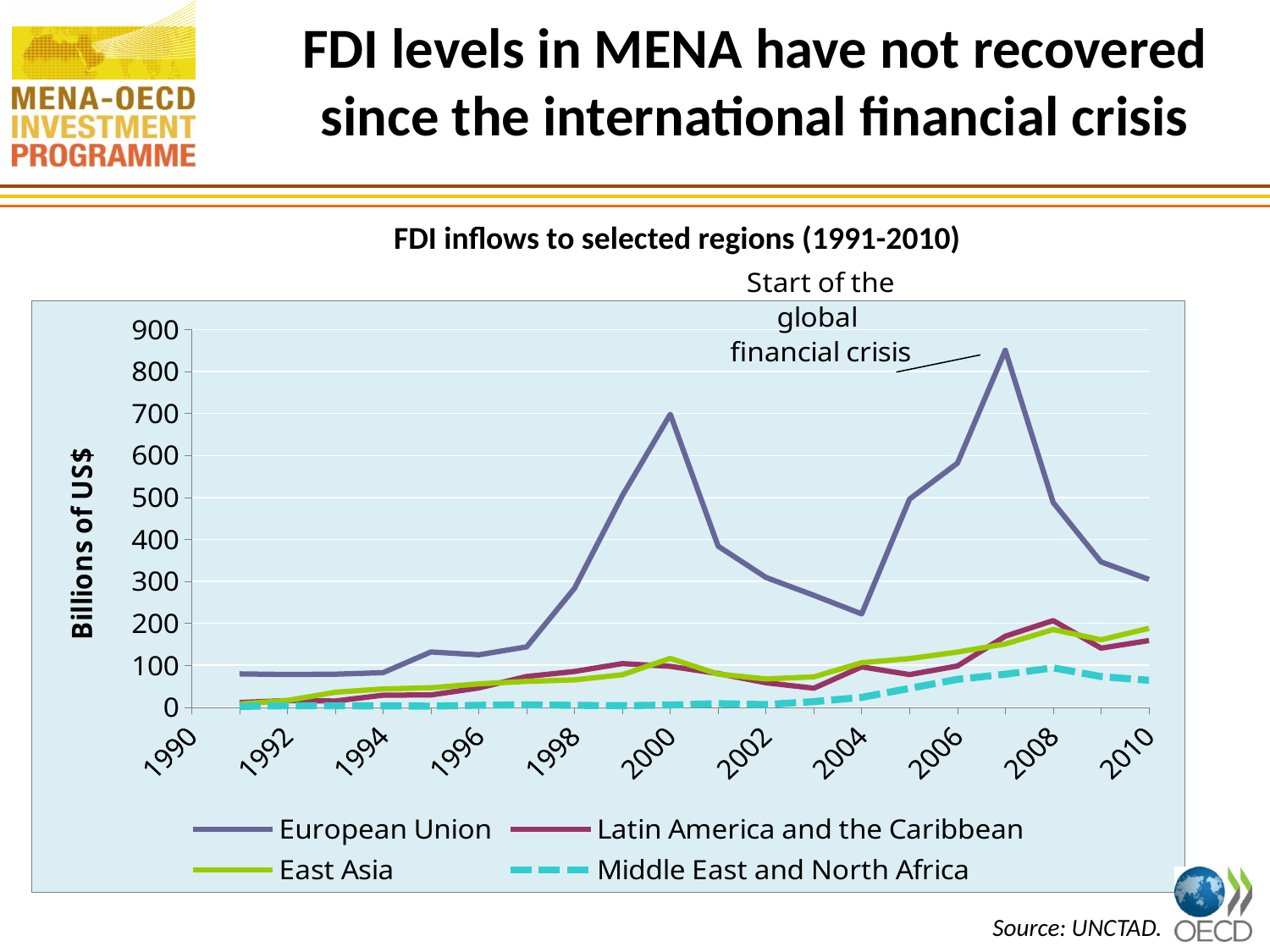
Is the value for European Union in 2010 greater or less than 400? less Which series has the highest value in 2007? European Union Do the values for European Union rise or fall from 2007 to 2010? fall In 2010, which is larger: East Asia or Latin America and the Caribbean? East Asia What is the title of the chart? FDI inflows to selected regions (1991-2010) Is the value for European Union in 2000 greater or less than 600? greater How many series does the legend list? 4 What kind of chart is shown on the slide? line chart What is the label on the vertical axis? Billions of US$ Which series has the lowest value in 2010? Middle East and North Africa Is the value for European Union in 2007 greater or less than 800? greater